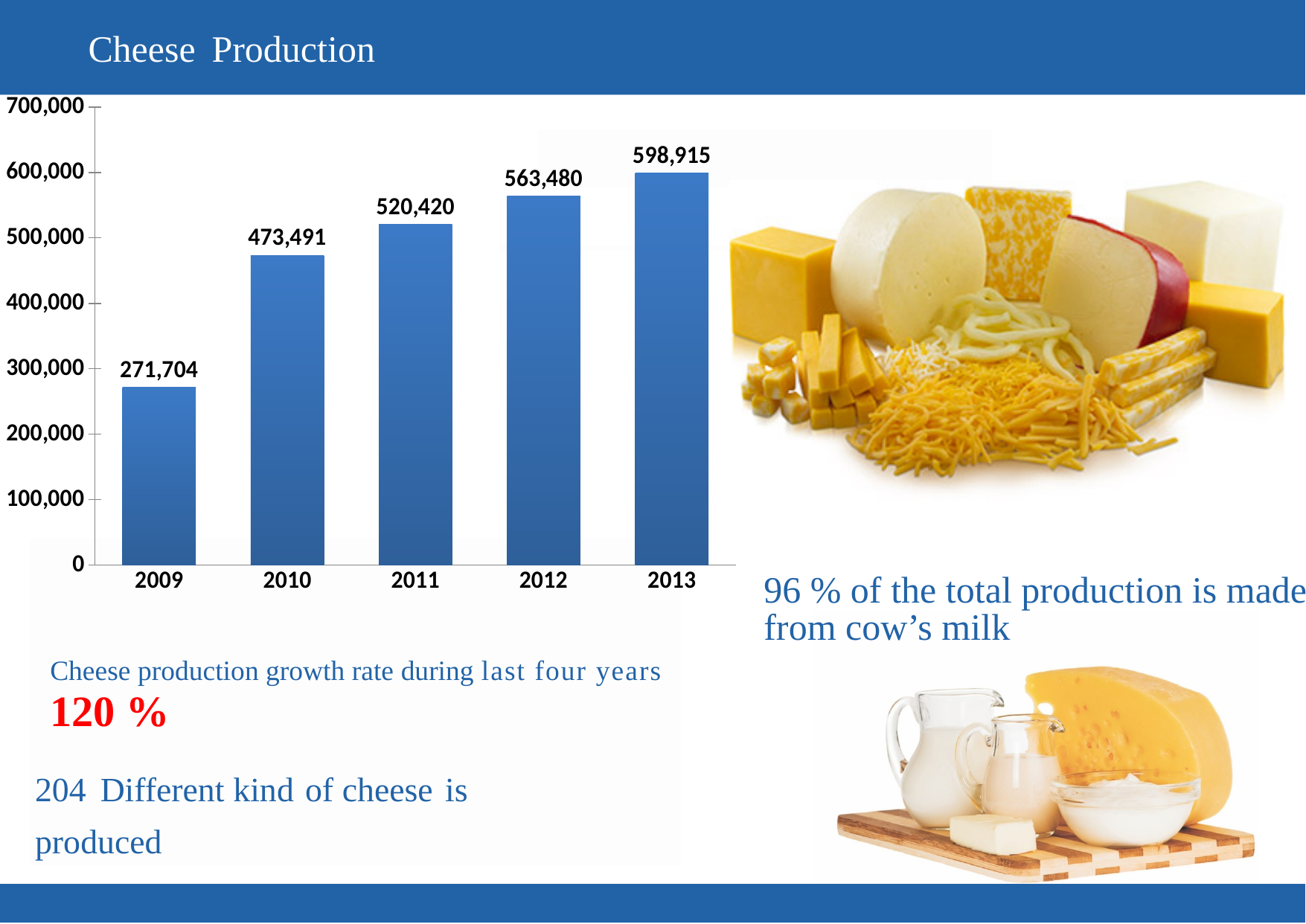
What is the cheese production value shown for 2009? 271,704 What kind of chart is used to show cheese production? Bar chart How many years are shown on the x axis of the chart? 5 What is the cheese production value shown for 2013? 598,915 Which year has the highest cheese production in the chart? 2013 Do the cheese production values rise or fall from 2009 to 2013? Rise Is the cheese production value for 2012 greater or less than 500,000? greater What is the cheese production value shown for 2011? 520,420 What is the difference between the cheese production values for 2010 and 2009? 201,787 What is the difference between the cheese production values for 2013 and 2009? 327,211 Which year has the lowest cheese production in the chart? 2009 Which year has the larger cheese production value, 2010 or 2012? 2012